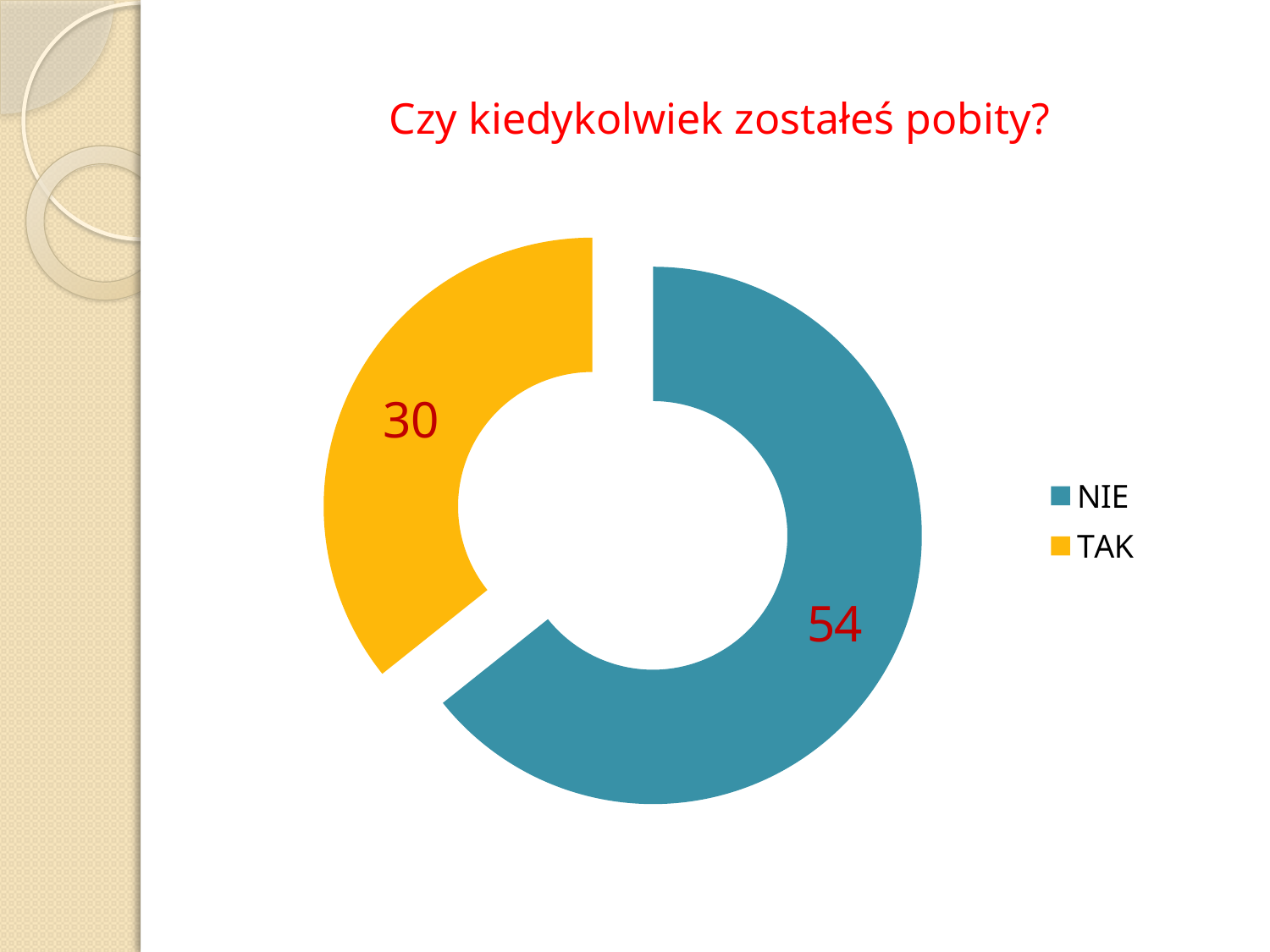
Which category has the highest value? NIE What is the title of the chart? Czy kiedykolwiek zostałeś pobity? What is the value for TAK? 30 How many categories does the chart show? 2 What is the difference between the values for NIE and TAK? 24 What is the value for NIE? 54 How many entries does the legend list? 2 Which is larger, the value for NIE or the value for TAK? NIE What kind of chart is shown on the slide? Doughnut chart Which category has the lowest value? TAK What colour is the TAK segment? Yellow What is the total of the two values shown in the chart? 84